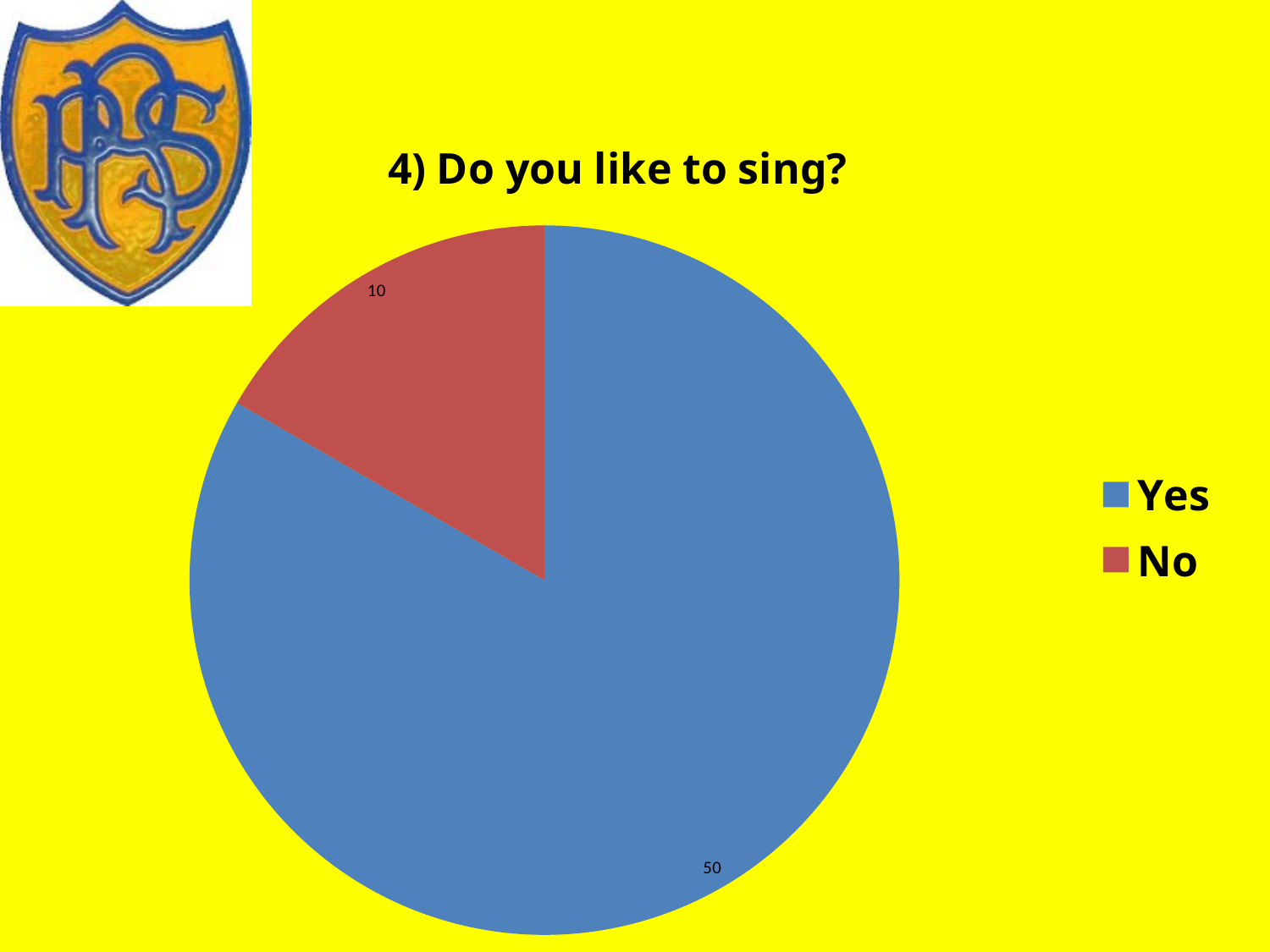
Which category has the largest slice? Yes What is the total of all slices in the pie chart? 60 How many categories does the pie chart have? 2 What colour is the Yes slice? blue Which is larger, the value for Yes or the value for No? Yes How many entries does the legend list? 2 What is the difference between the Yes and No values? 40 Which category has the smallest slice? No What type of chart is shown on the slide? pie chart What is the value for Yes? 50 What is the value for No? 10 What is the title of the chart? 4) Do you like to sing?